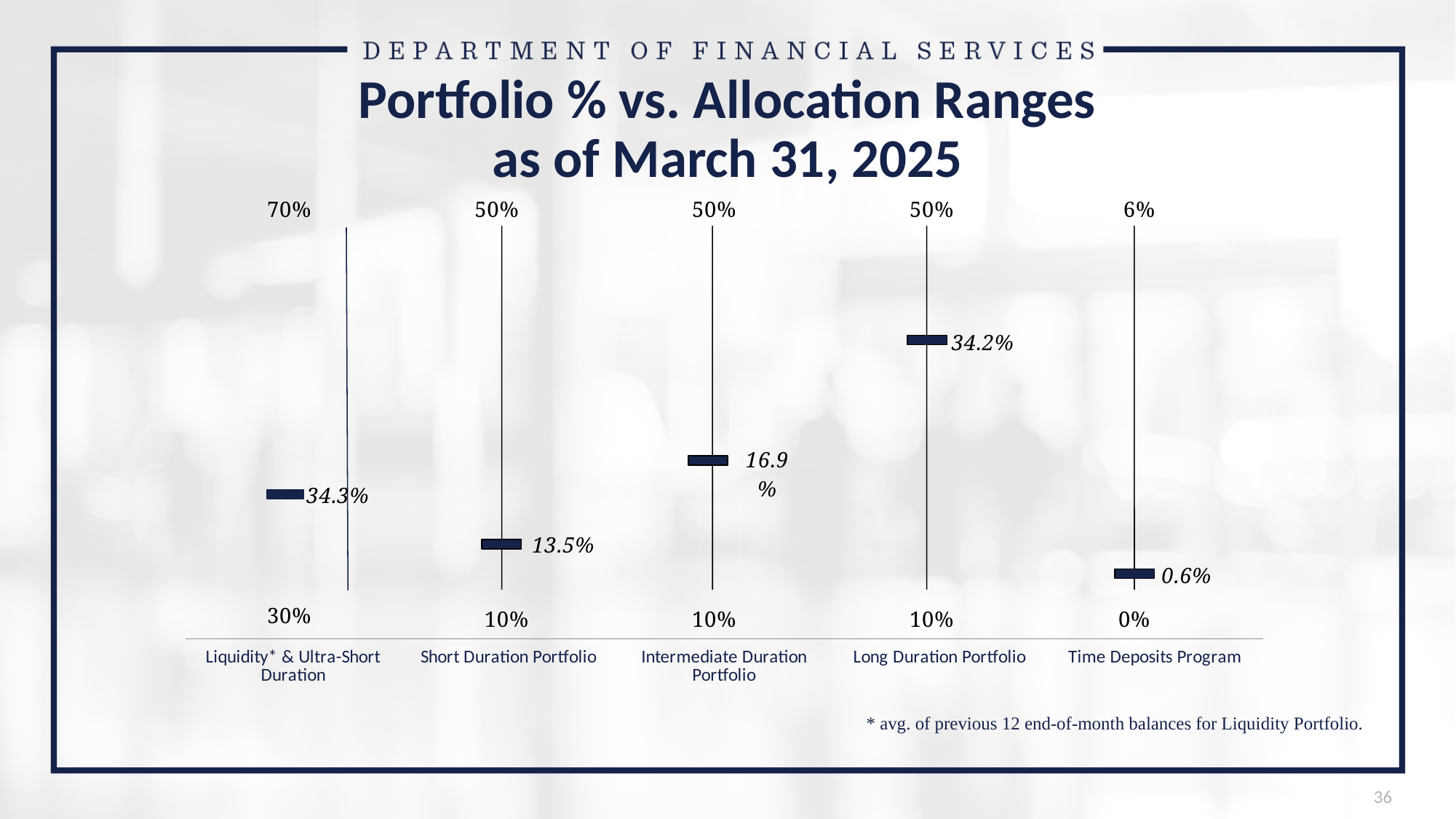
Which category has the lowest portfolio %? Time Deposits Program What is the portfolio % for the Long Duration Portfolio? 34.2% What is the upper allocation limit shown for Liquidity* & Ultra-Short Duration? 70% What is the portfolio % for the Intermediate Duration Portfolio? 16.9% Which has a larger portfolio %, the Intermediate Duration Portfolio or the Short Duration Portfolio? Intermediate Duration Portfolio What is the difference between the portfolio % of the Long Duration Portfolio and the Short Duration Portfolio? 20.7% What is the lower allocation limit shown for the Time Deposits Program? 0% What is the portfolio % for Liquidity* & Ultra-Short Duration? 34.3% What is the portfolio % for the Time Deposits Program? 0.6% How many portfolio categories are shown on the chart? 5 What is the portfolio % for the Short Duration Portfolio? 13.5% What is the title of the chart? Portfolio % vs. Allocation Ranges as of March 31, 2025